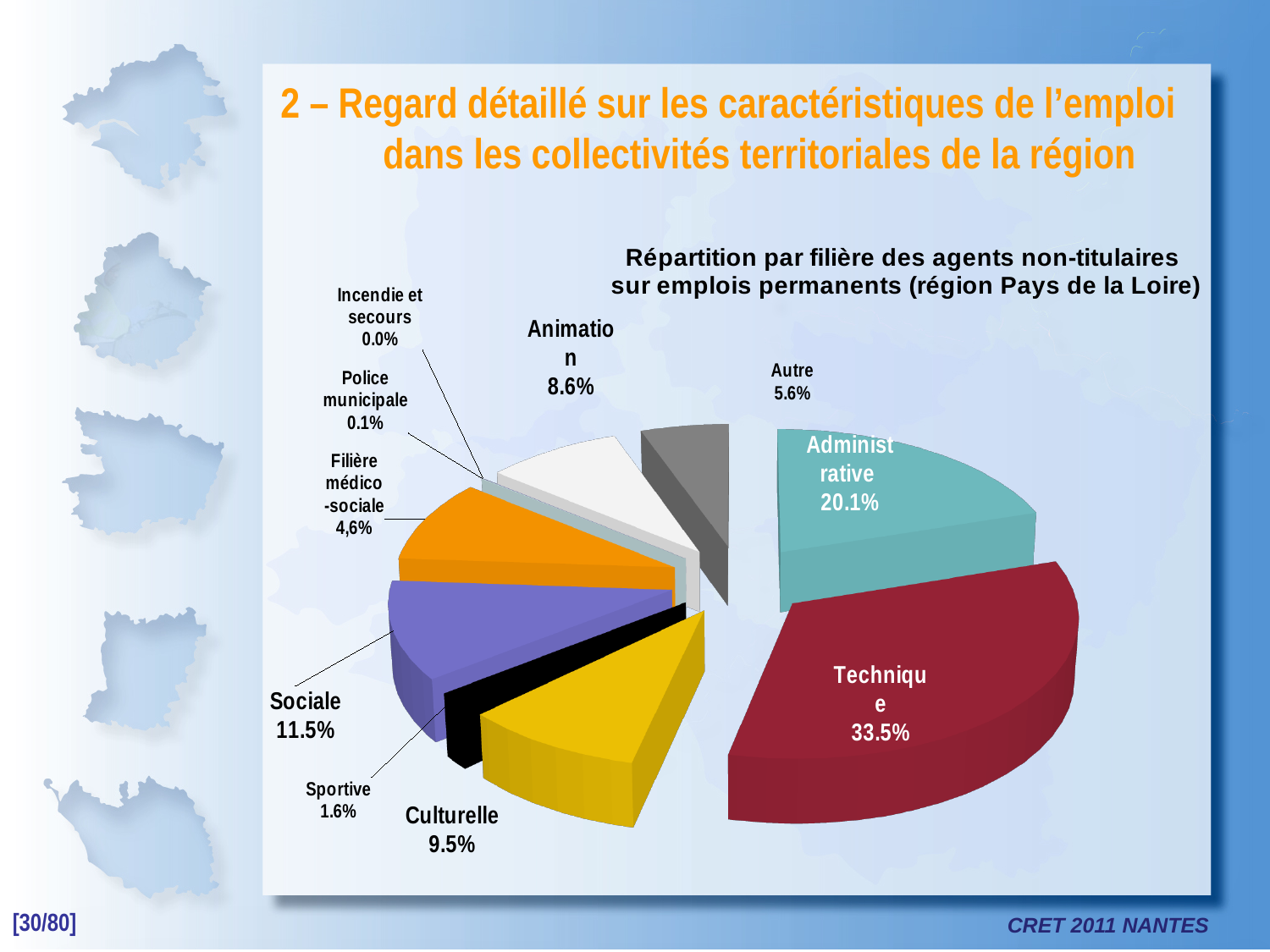
Which filière has the largest share of the pie? Technique Which is larger, the share for Sociale or the share for Culturelle? Sociale What is the share for the Administrative filière? 20.1% What is the difference between the Technique share and the Administrative share? 13.4% What type of chart is shown on the slide? Pie chart What is the share for the Sociale filière? 11.5% What is the share for Police municipale? 0.1% What is the share for the Culturelle filière? 9.5% What is the share for the Technique filière? 33.5% How many categories (filières) are shown in the pie chart? 10 Which filière has the smallest share of the pie? Incendie et secours What is the share for Animation? 8.6%